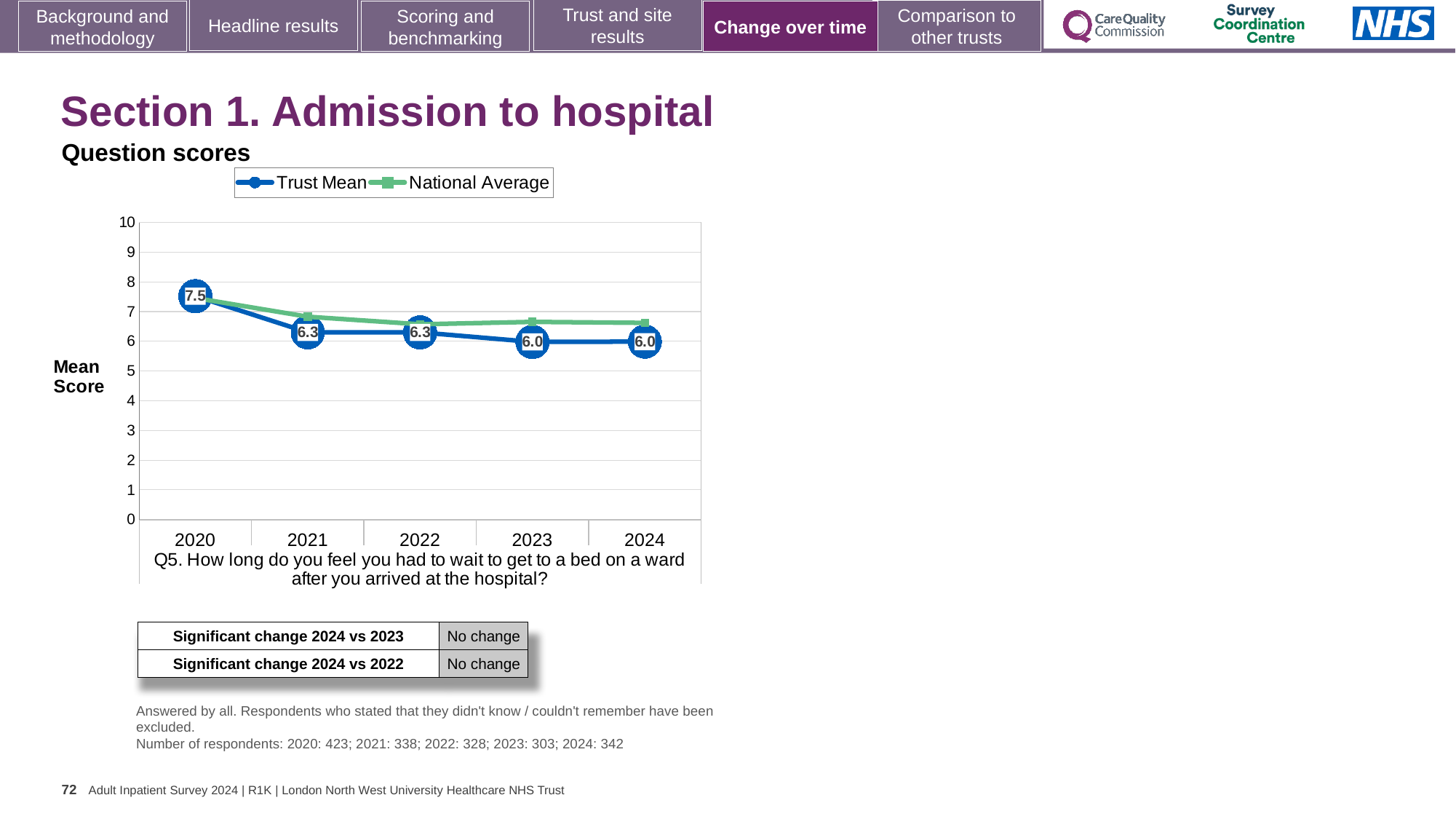
How many series does the chart legend list? 2 What kind of chart is shown on the slide? Line chart What is the difference between the Trust Mean score in 2020 and in 2024? 1.5 What is the Trust Mean score for 2022? 6.3 In which year is the Trust Mean score highest? 2020 Does the Trust Mean score rise or fall from 2020 to 2024? Fall What is the difference between the Trust Mean score in 2021 and in 2023? 0.3 How many years are shown on the x axis of the chart? 5 Is the National Average value for 2021 greater or less than 6? greater What is the Trust Mean score for 2020? 7.5 What is the Trust Mean score for 2024? 6.0 Which is larger, the Trust Mean score in 2020 or in 2021? 2020